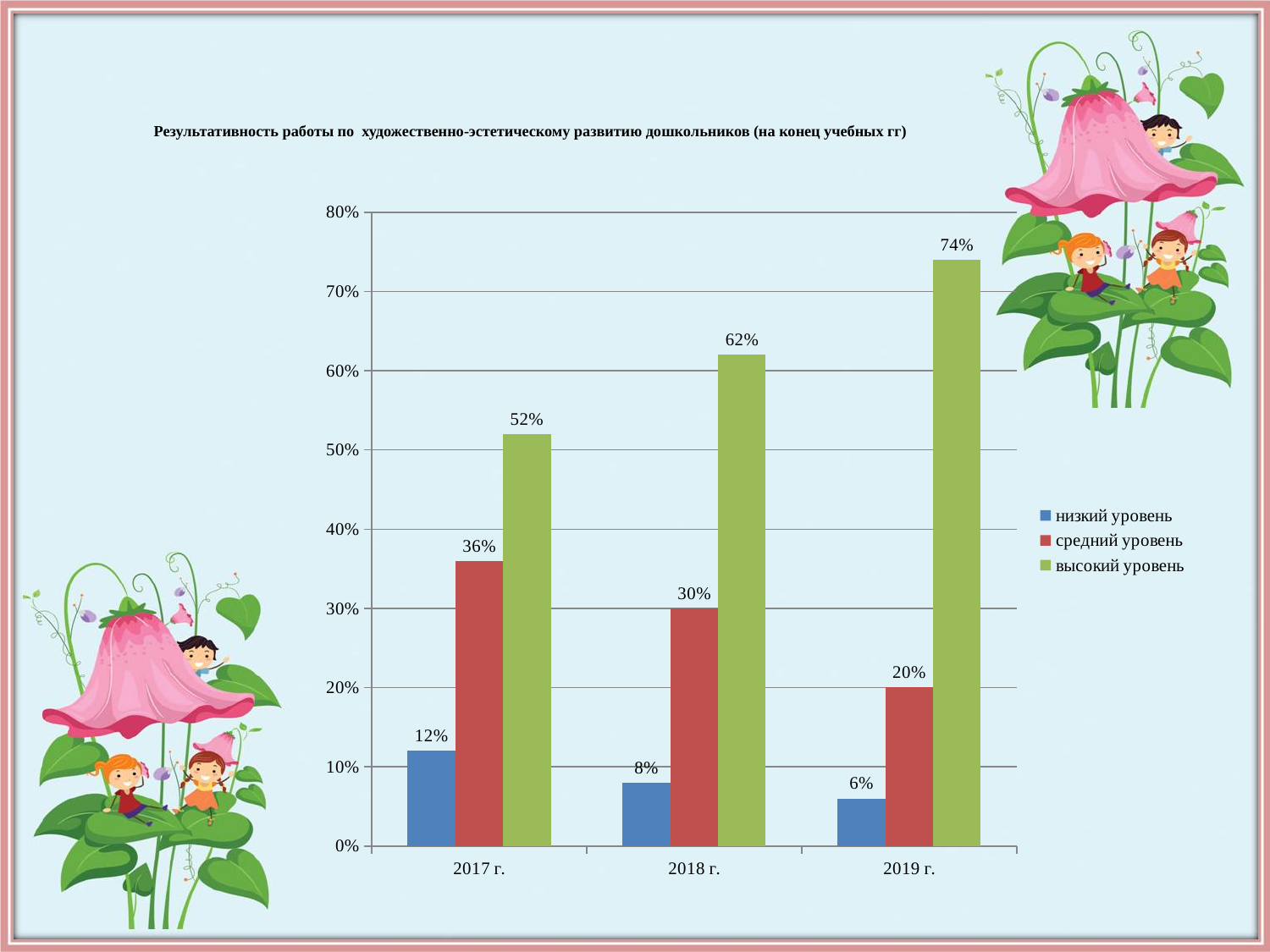
What is the value for высокий уровень in 2019 г.? 74% Which is larger: средний уровень in 2017 г. or средний уровень in 2019 г.? средний уровень in 2017 г. How many series does the legend list? 3 Which colour represents низкий уровень in the legend? blue What kind of chart is shown on the slide? bar chart What is the value for средний уровень in 2018 г.? 30% Do the values for высокий уровень rise or fall from 2017 г. to 2019 г.? rise In which year is the value for низкий уровень the lowest? 2019 г. In which year is the value for высокий уровень the highest? 2019 г. What is the difference between the высокий уровень values for 2019 г. and 2017 г.? 22% What is the value for низкий уровень in 2017 г.? 12% How many years are shown on the x axis? 3